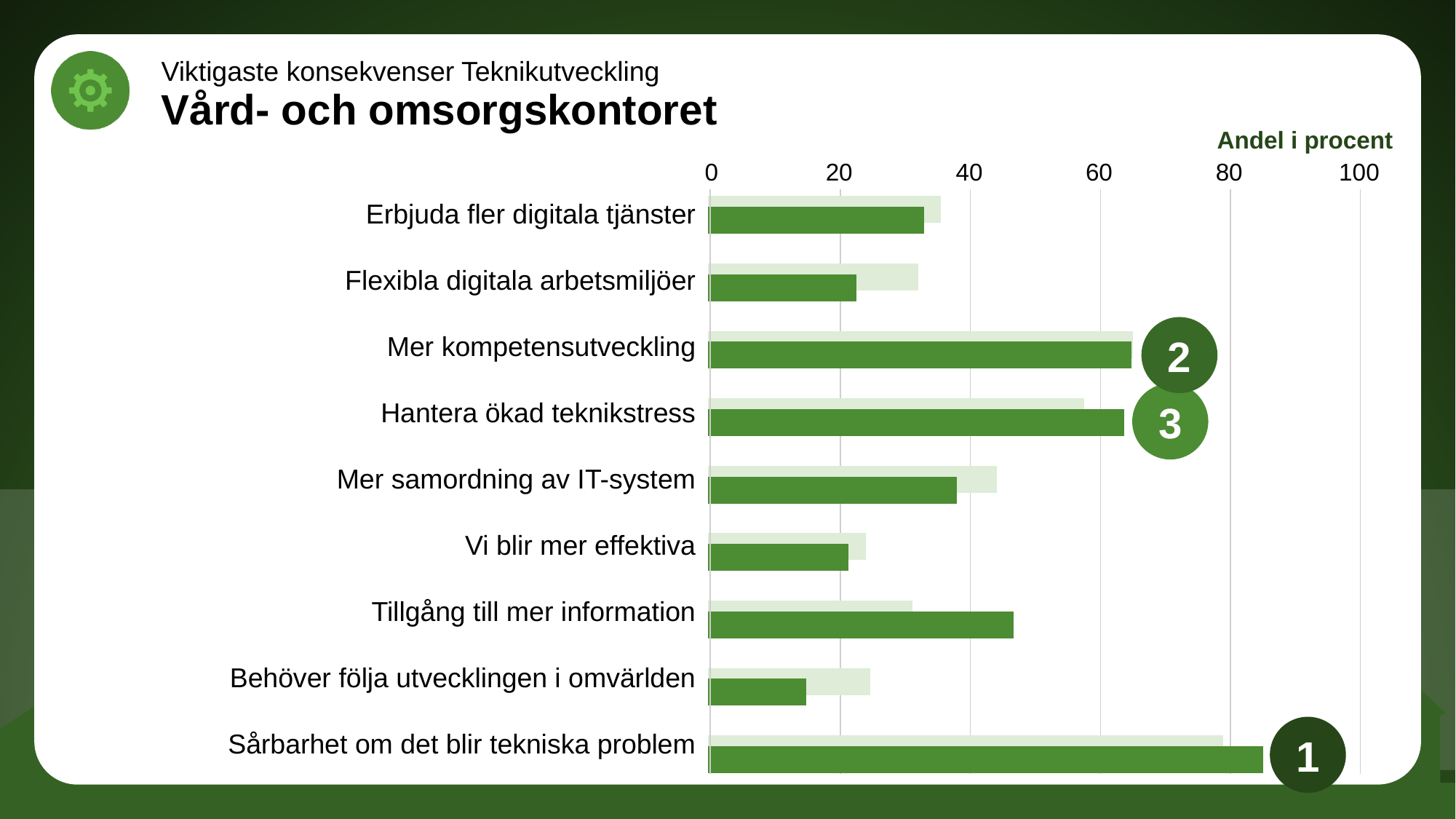
Is the dark green value for Behöver följa utvecklingen i omvärlden greater or less than 20? less Which category has the longest light green bar? Sårbarhet om det blir tekniska problem Is the dark green value for Tillgång till mer information greater or less than 40? greater Is the dark green value for Mer kompetensutveckling greater or less than 60? greater What kind of chart is shown on the slide? bar chart Which has the larger dark green value: Tillgång till mer information or Mer samordning av IT-system? Tillgång till mer information Which category has the longest dark green bar? Sårbarhet om det blir tekniska problem What label is shown above the horizontal axis of the chart? Andel i procent Which category has the shortest dark green bar? Behöver följa utvecklingen i omvärlden How many categories are listed on the chart? 9 How many bars are shown for each category on the chart? 2